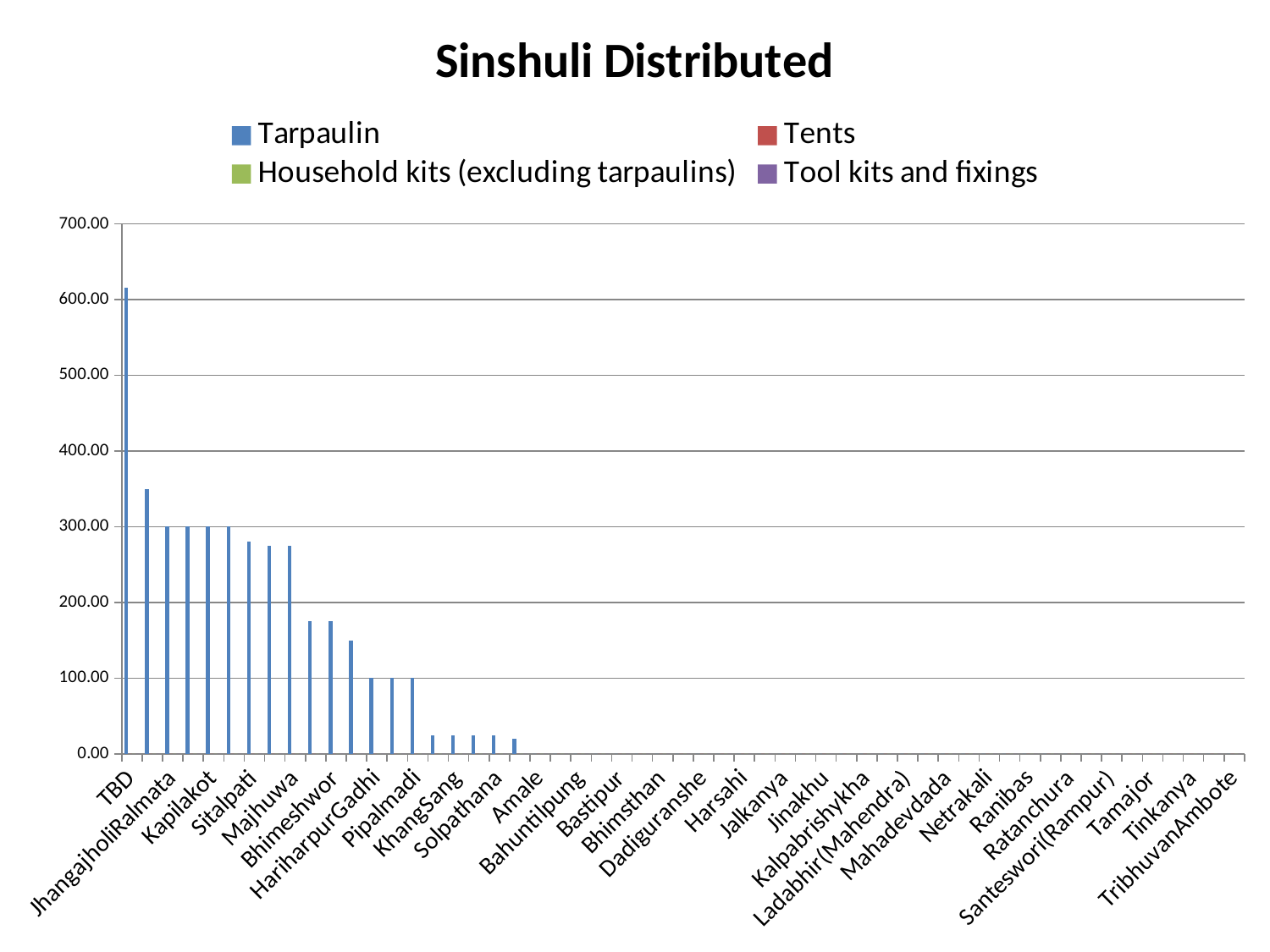
What kind of chart is shown on the slide? bar chart Do the Tarpaulin values generally rise or fall from left to right along the x axis? fall Is the Tarpaulin value for Bhimeshwor greater or less than 100? greater Is the Tarpaulin value for Bhimeshwor greater or less than 200? less What is the title of the chart? Sinshuli Distributed Is the Tarpaulin value for TBD greater or less than 600? greater How many series does the legend list? 4 Which category has the highest Tarpaulin value? TBD Which colour represents Tarpaulin in the legend? blue Which has the larger Tarpaulin value, TBD or Bhimeshwor? TBD